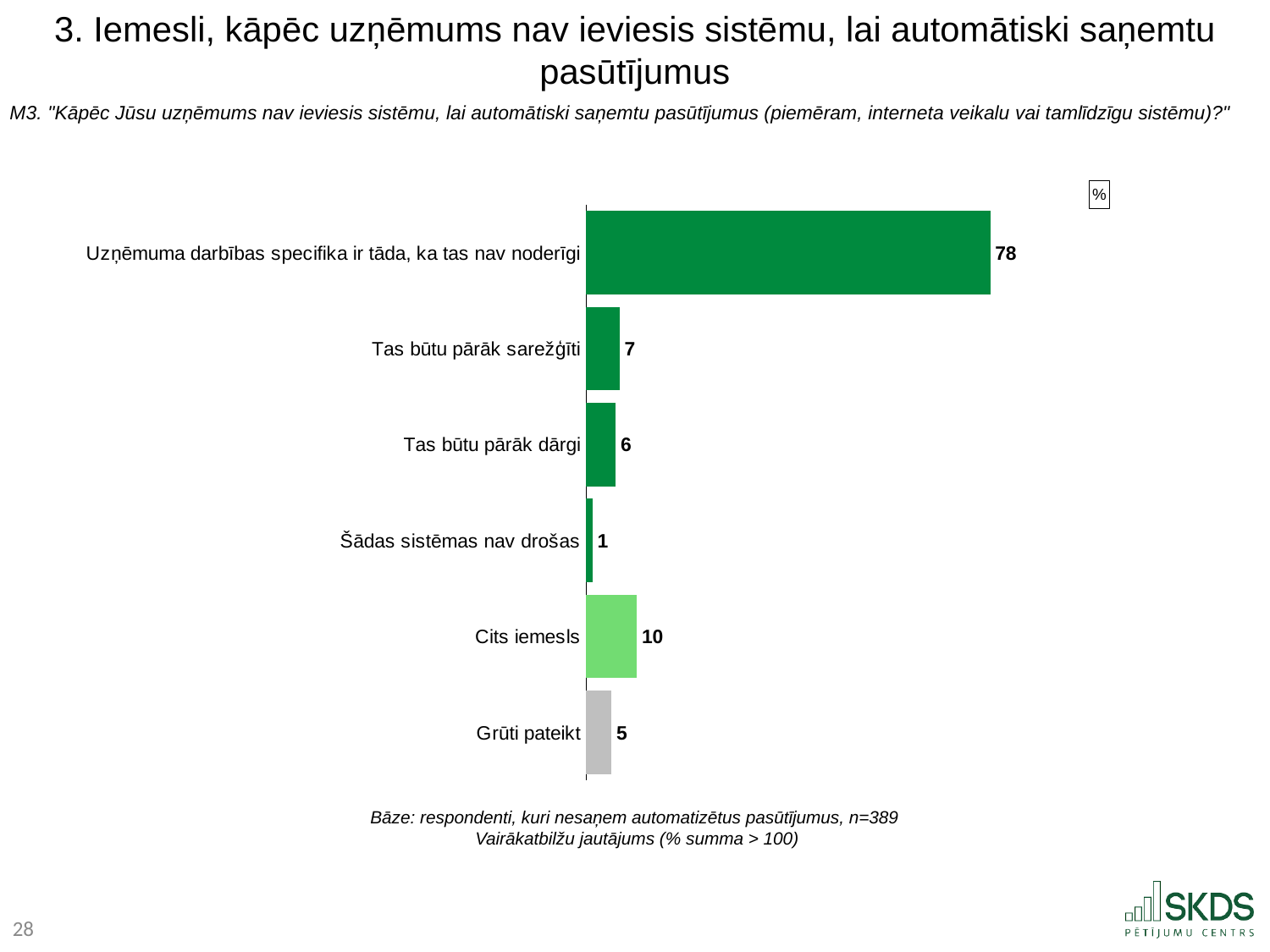
Which category has the highest value? Uzņēmuma darbības specifika ir tāda, ka tas nav noderīgi What is the base size (n) stated below the chart? n=389 What is the value for "Cits iemesls"? 10 How many categories are shown in the chart? 6 What is the value for "Tas būtu pārāk dārgi"? 6 What is the value for "Uzņēmuma darbības specifika ir tāda, ka tas nav noderīgi"? 78 What is the value for "Tas būtu pārāk sarežģīti"? 7 What is the value for "Grūti pateikt"? 5 Which is larger, the value for "Tas būtu pārāk sarežģīti" or the value for "Tas būtu pārāk dārgi"? Tas būtu pārāk sarežģīti What kind of chart is shown on the slide? Bar chart Which category has the lowest value? Šādas sistēmas nav drošas What is the difference between the values for "Uzņēmuma darbības specifika ir tāda, ka tas nav noderīgi" and "Cits iemesls"? 68